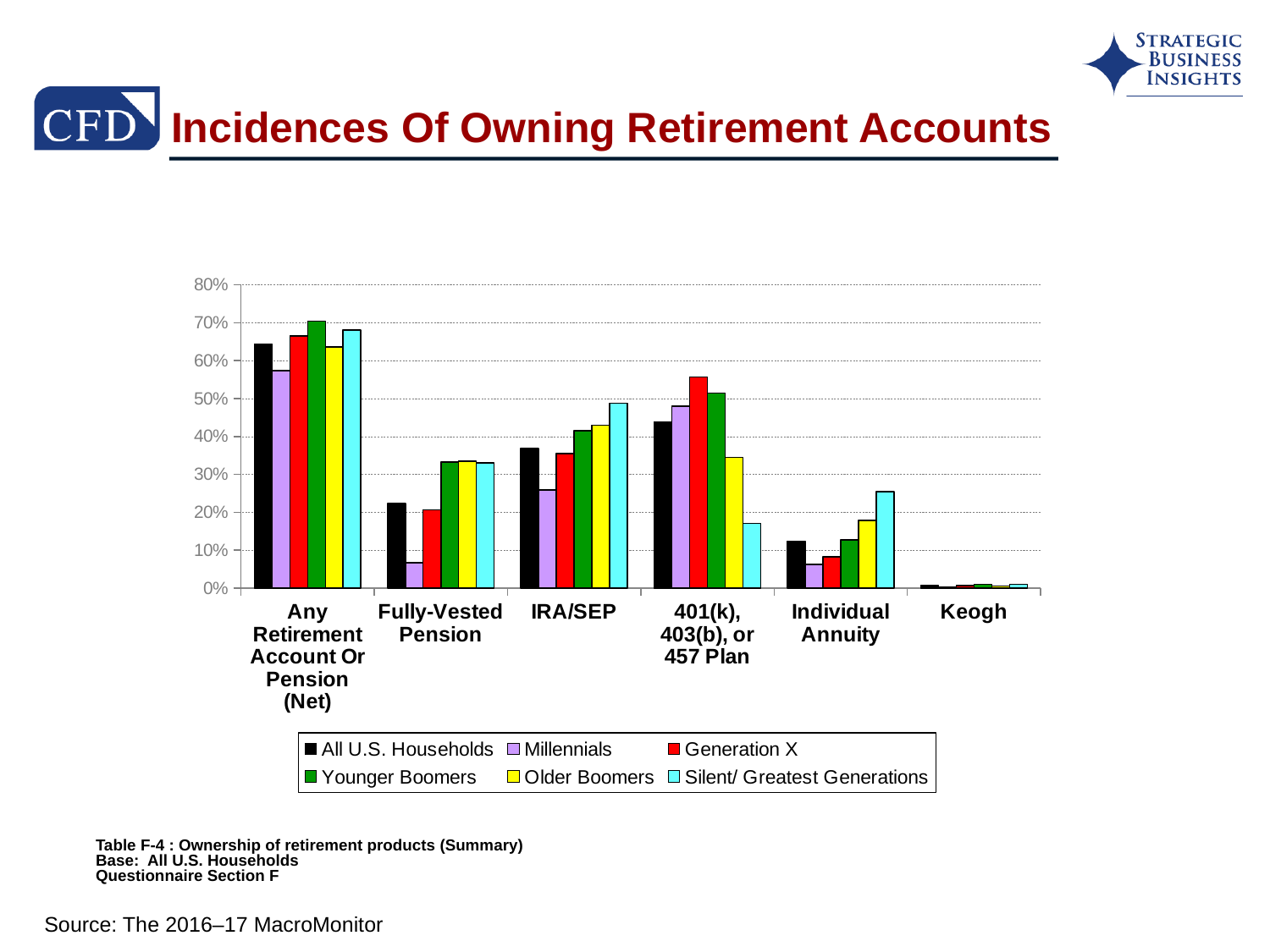
Which category has the lowest values across all series? Keogh What is the title of the chart? Incidences Of Owning Retirement Accounts Is the value for Millennials in Any Retirement Account Or Pension (Net) greater or less than 60%? less Which series has the lowest value for Fully-Vested Pension? Millennials Which series has the highest value for 401(k), 403(b), or 457 Plan? Generation X How many retirement account categories are shown on the x axis? 6 Is the value for Silent/ Greatest Generations in IRA/SEP greater or less than 40%? greater Which series has the highest value for Individual Annuity? Silent/ Greatest Generations How many series does the legend list? 6 Is the value for Silent/ Greatest Generations in 401(k), 403(b), or 457 Plan greater or less than 20%? less What kind of chart is shown on the slide? Bar chart For Individual Annuity, which is larger: Older Boomers or Silent/ Greatest Generations? Silent/ Greatest Generations